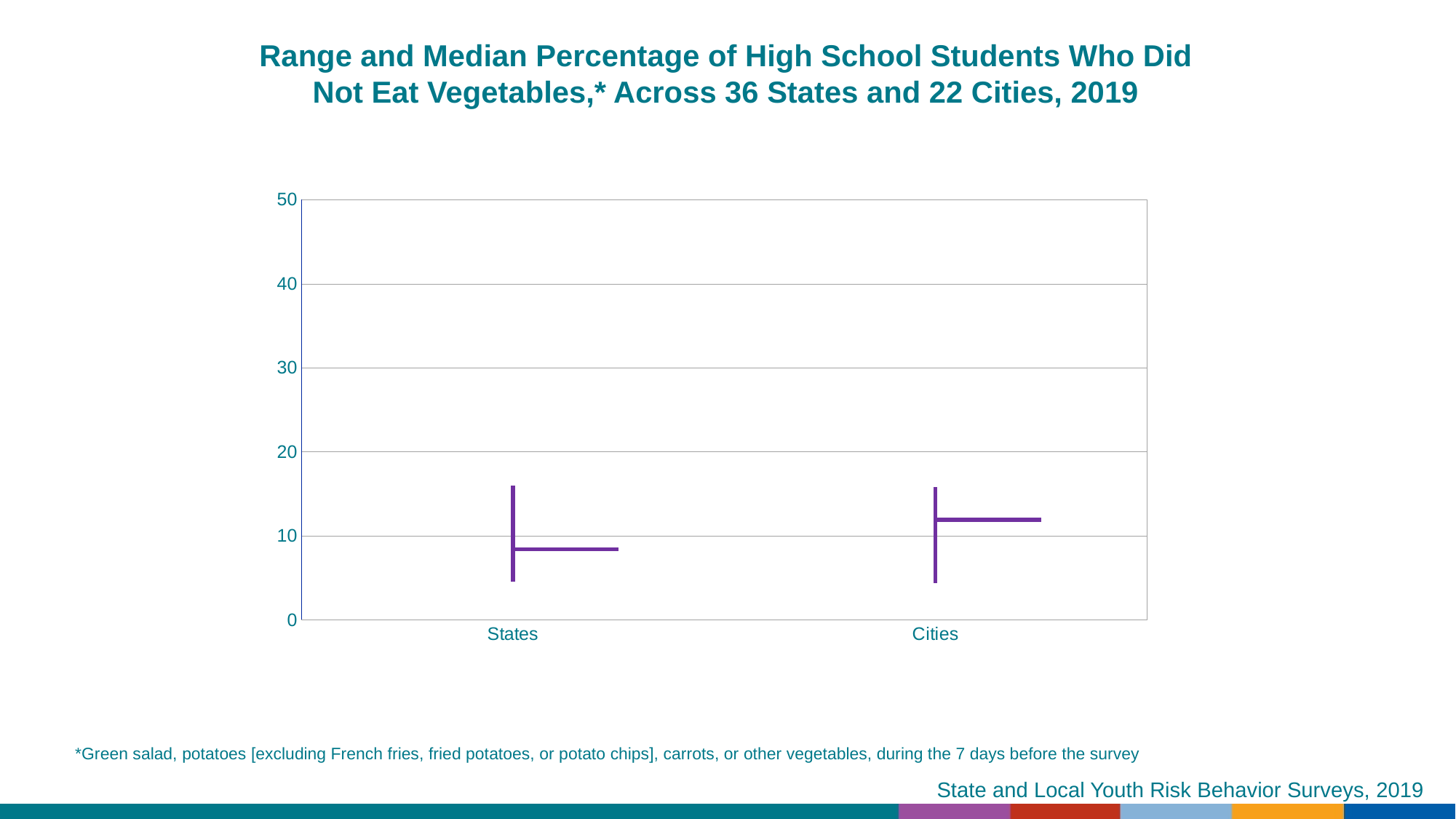
Is the top of the range for Cities greater or less than 10? greater Is the median value for States greater or less than 10? less Which category has the higher median percentage, States or Cities? Cities What is the maximum value shown on the y axis of the chart? 50 Is the median value for Cities greater or less than 10? greater How many categories are shown on the x axis of the chart? 2 What are the two categories shown on the x axis? States and Cities What kind of chart is shown on the slide? Range and median (high-low) chart